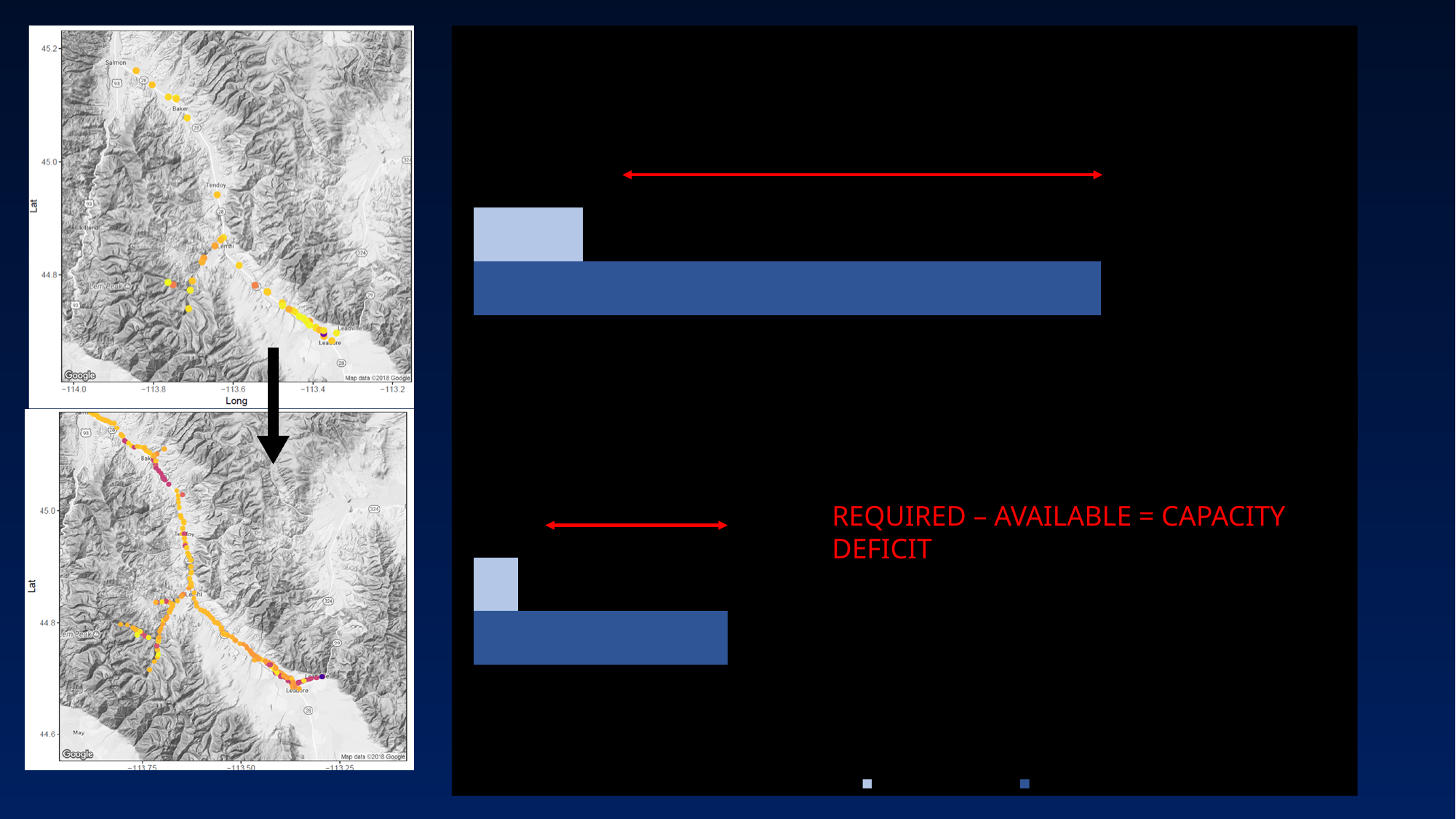
In the bar chart on the right, are the bars drawn horizontally or vertically? horizontally In the bar chart on the right, which bar in the upper group is longer, the light blue bar or the dark blue bar? the dark blue bar In the bar chart on the right, is the dark blue bar in the upper group longer or shorter than the dark blue bar in the lower group? longer In the bar chart on the right, how many groups of bars are plotted? 2 What formula is written in red text next to the bar chart on the right? REQUIRED – AVAILABLE = CAPACITY DEFICIT In the bar chart on the right, is the light blue bar in the upper group longer or shorter than the light blue bar in the lower group? longer In the bar chart on the right, which single bar is the longest? the dark blue bar in the upper group In the bar chart on the right, how many series does the legend list? 2 What kind of chart is shown on the right side of the slide? bar chart In the bar chart on the right, which single bar is the shortest? the light blue bar in the lower group